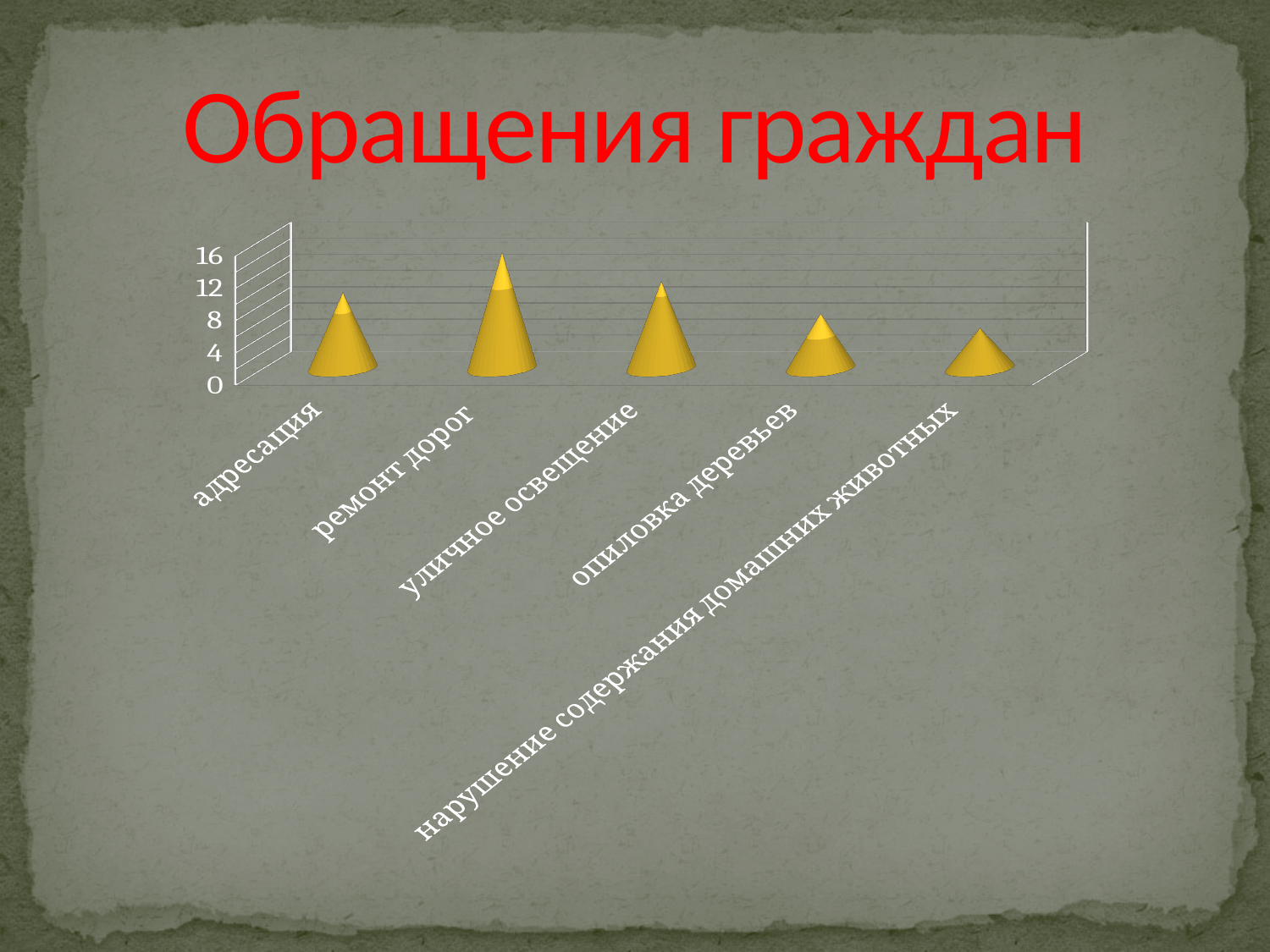
How many categories are shown on the chart? 5 Which category has the lowest value? нарушение содержания домашних животных Is the value for нарушение содержания домашних животных greater or less than 8? less What is the highest tick value shown on the vertical axis? 16 Is the value for ремонт дорог greater or less than 12? greater Is the value for адресация greater or less than 12? less Which category has the highest value? ремонт дорог Which is larger, the value for ремонт дорог or the value for адресация? ремонт дорог What is the title of the chart on the slide? Обращения граждан Which is larger, the value for уличное освещение or the value for нарушение содержания домашних животных? уличное освещение What kind of chart is shown on the slide? bar chart